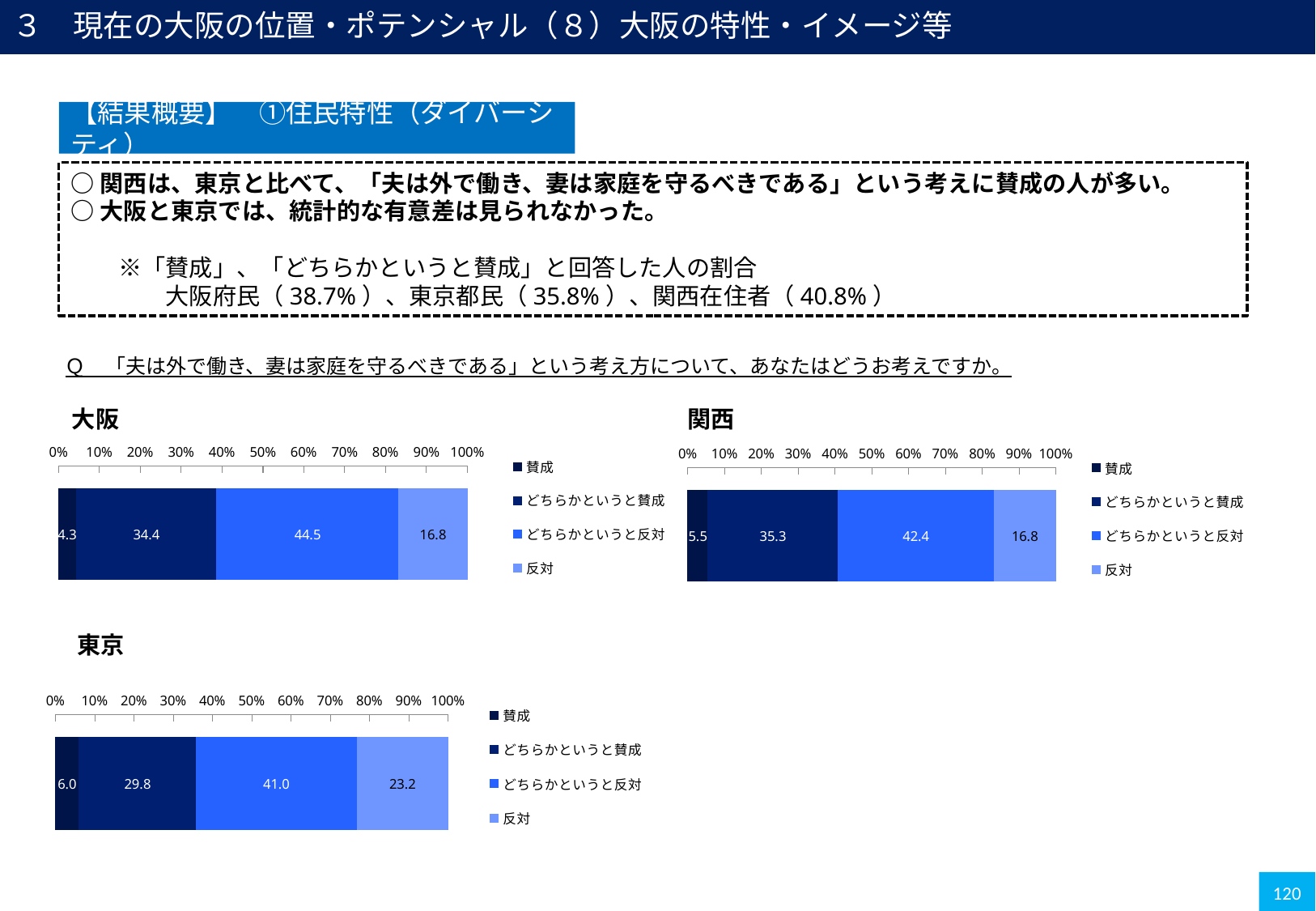
How many series does the legend of the 関西 chart list? 4 In the 大阪 chart, what is the total of 賛成 and どちらかというと賛成? 38.7 In the 東京 chart, what is the value for 賛成? 6.0 In the 大阪 chart, which segment has the largest value? どちらかというと反対 In the 関西 chart, what is the value for どちらかというと賛成? 35.3 What kind of chart is the 大阪 chart? Stacked bar chart What is the first legend entry in the 東京 chart? 賛成 In the 東京 chart, what is the value for 反対? 23.2 Which is larger: 反対 in the 東京 chart or 反対 in the 大阪 chart? 東京 In the 関西 chart, which segment has the smallest value? 賛成 In the 東京 chart, what is the difference between どちらかというと反対 and どちらかというと賛成? 11.2 In the 大阪 chart, what is the value for どちらかというと反対? 44.5